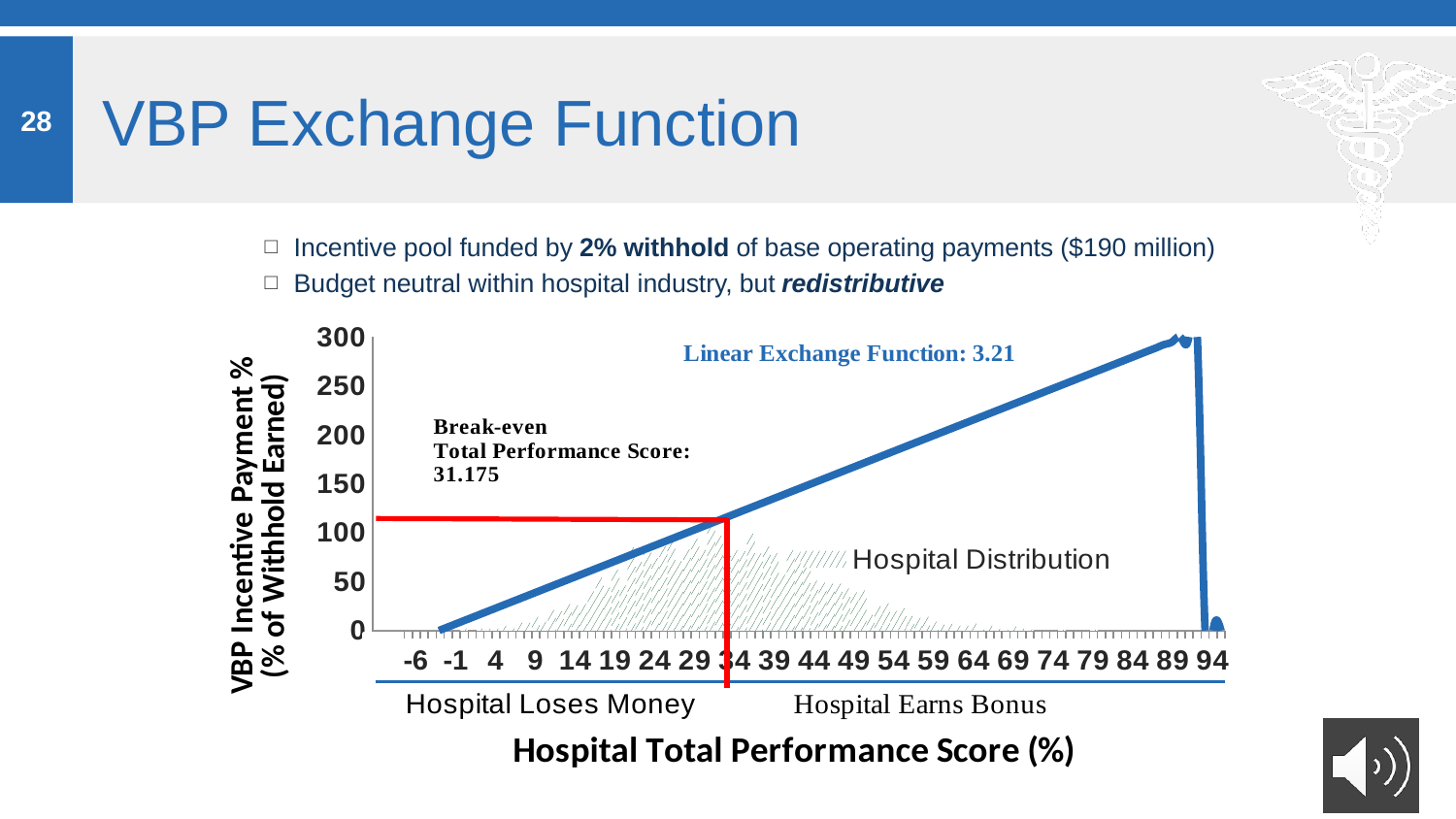
What is the highest tick label shown on the x axis of the chart? 94 What is the lowest tick label shown on the x axis of the chart? -6 Is the VBP Incentive Payment value at a Hospital Total Performance Score of 14 greater or less than 100? less What is the title of the x axis of the chart? Hospital Total Performance Score (%) What is the title of the y axis of the chart? VBP Incentive Payment % (% of Withhold Earned) Is the VBP Incentive Payment value at a Hospital Total Performance Score of 64 greater or less than 150? greater What value is given for the Linear Exchange Function on the chart? 3.21 What kind of chart is shown on the slide? combination bar and line chart Is the VBP Incentive Payment value at a Hospital Total Performance Score of 89 greater or less than 250? greater Does the VBP Incentive Payment line rise or fall as the Hospital Total Performance Score increases from -1 to 89? rise What break-even Total Performance Score is annotated on the chart? 31.175 What is the highest tick value shown on the y axis of the chart? 300